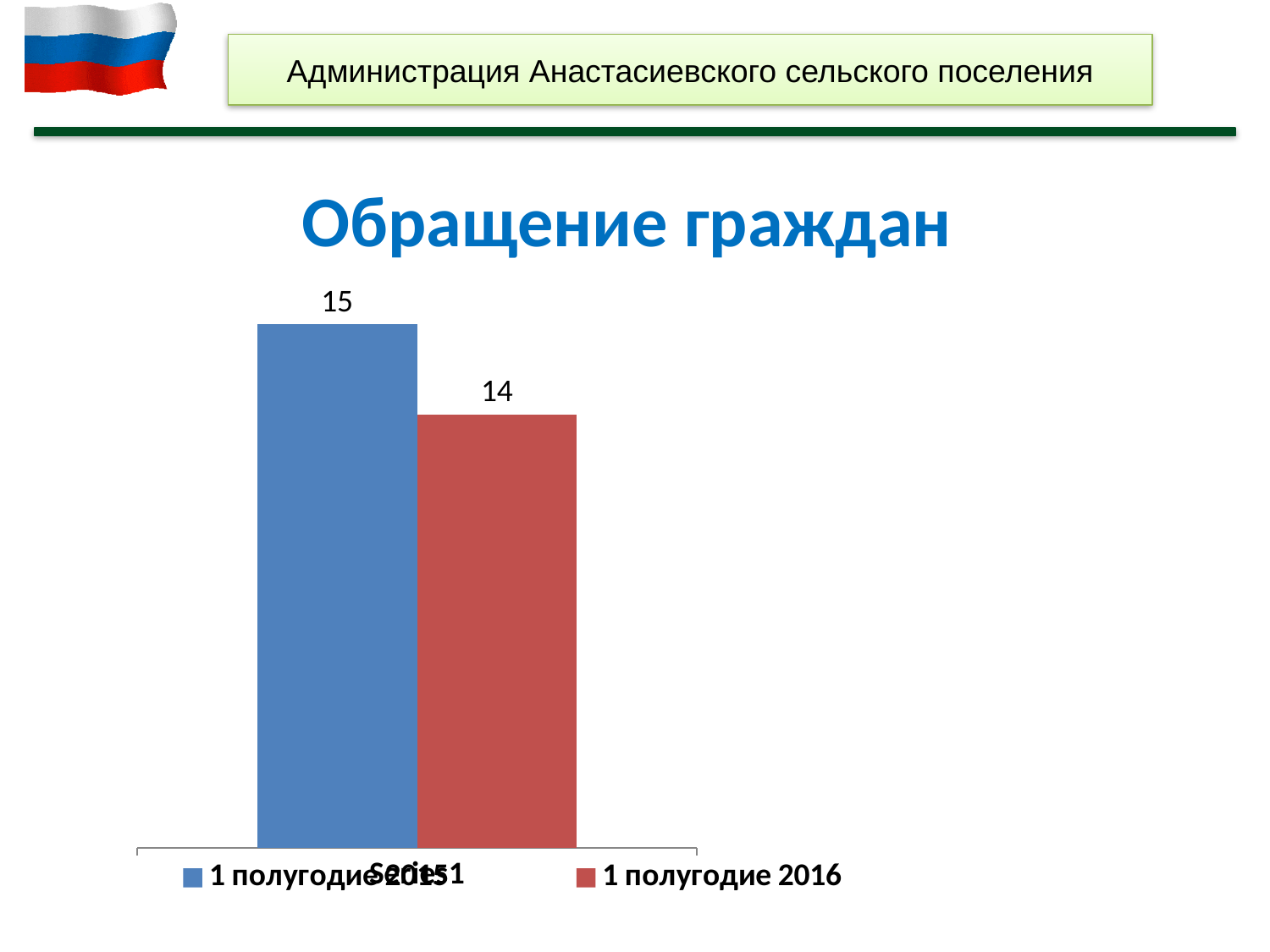
How many bars are plotted in the chart? 2 How many series does the legend list? 2 Which series has the lowest value? 1 полугодие 2016 Which series has the higher value, 1 полугодие 2015 or 1 полугодие 2016? 1 полугодие 2015 Did the value fall or rise from 1 полугодие 2015 to 1 полугодие 2016? fall What is the title of the chart? Обращение граждан What is the value for 1 полугодие 2015? 15 Which series has the highest value? 1 полугодие 2015 What is the value for 1 полугодие 2016? 14 What is the difference between the values for 1 полугодие 2015 and 1 полугодие 2016? 1 What colour is the bar for 1 полугодие 2016? red What kind of chart is shown on the slide? bar chart